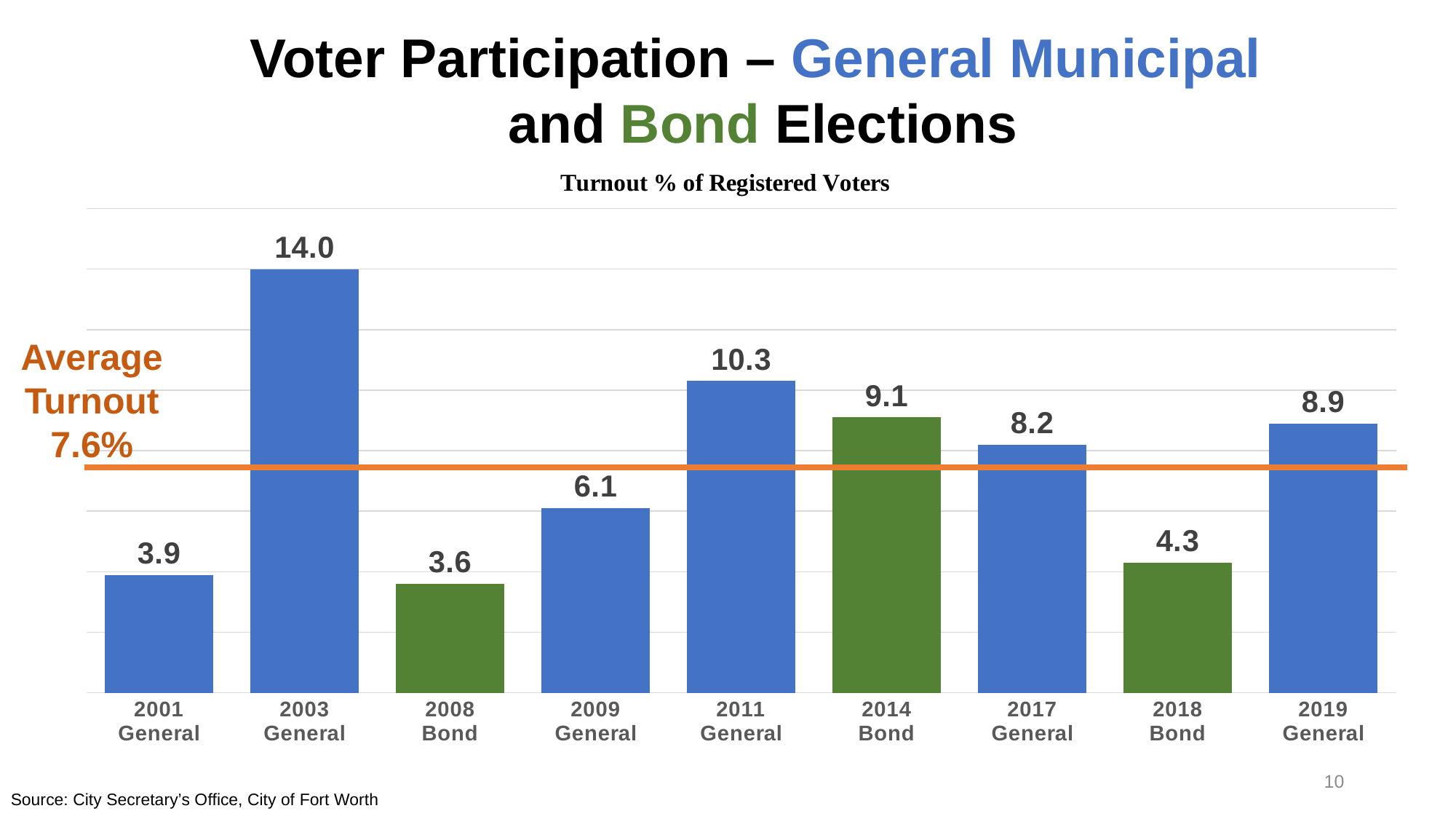
What is the turnout % of registered voters for the 2003 General election? 14.0 What is the turnout % of registered voters for the 2014 Bond election? 9.1 What kind of chart is shown on the slide? Bar chart What is the difference in turnout % between the 2019 General and 2017 General elections? 0.7 Which has a higher turnout %, the 2014 Bond election or the 2017 General election? 2014 Bond What is the difference in turnout % between the 2003 General and 2011 General elections? 3.7 How many elections are shown on the chart? 9 Which election has the highest turnout % of registered voters? 2003 General Which election has the lowest turnout % of registered voters? 2008 Bond What is the turnout % of registered voters for the 2018 Bond election? 4.3 What average turnout value is marked by the orange line on the chart? 7.6% Which has a higher turnout %, the 2001 General election or the 2018 Bond election? 2018 Bond